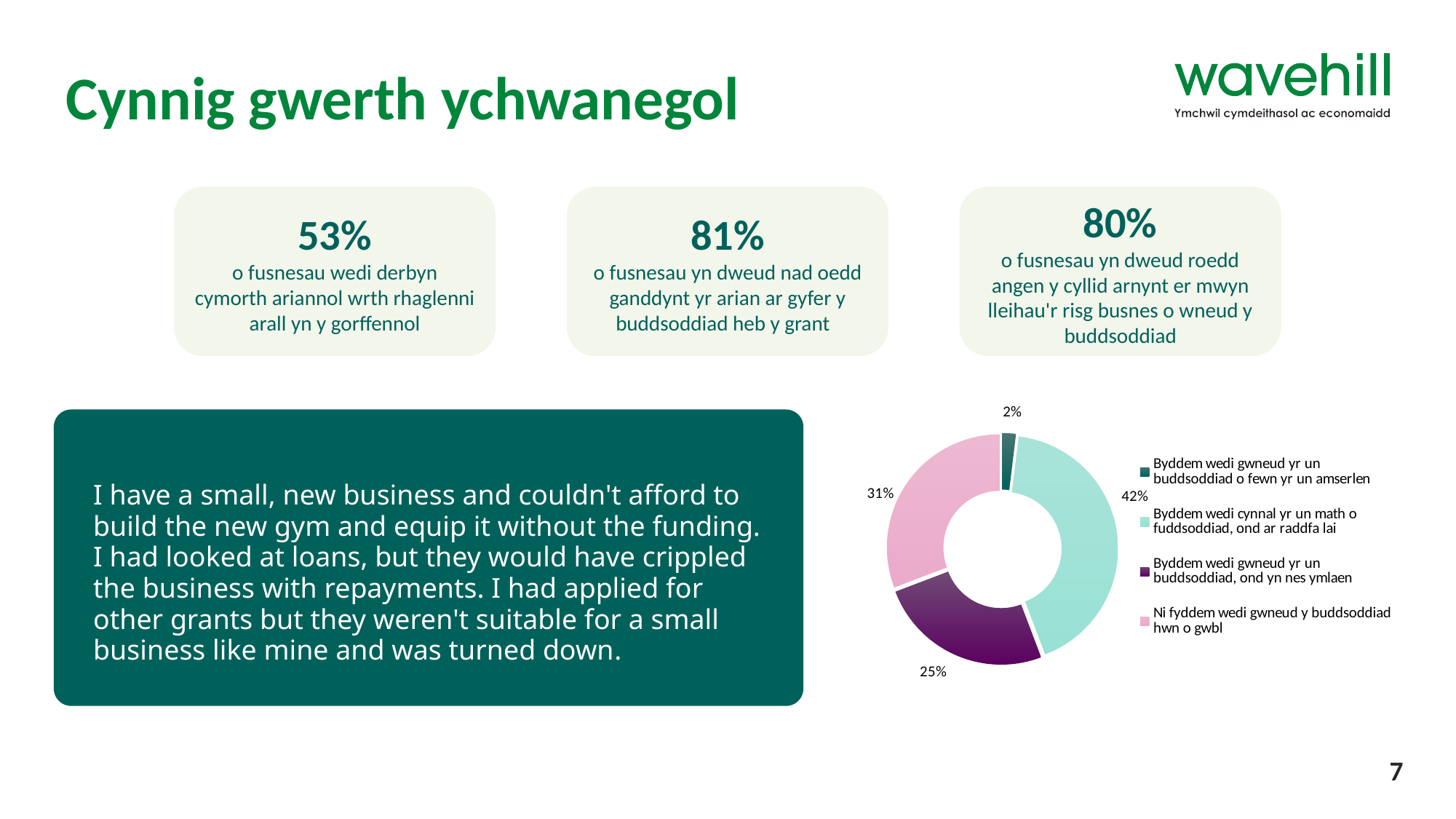
Which category has the smallest share of the donut chart? Byddem wedi gwneud yr un buddsoddiad o fewn yr un amserlen What percentage of the donut chart is for 'Ni fyddem wedi gwneud y buddsoddiad hwn o gwbl'? 31% Which is larger in the donut chart: 'Ni fyddem wedi gwneud y buddsoddiad hwn o gwbl' or 'Byddem wedi gwneud yr un buddsoddiad, ond yn nes ymlaen'? Ni fyddem wedi gwneud y buddsoddiad hwn o gwbl What percentage of the donut chart is for 'Byddem wedi cynnal yr un math o fuddsoddiad, ond ar raddfa lai'? 42% How many categories does the donut chart show? 4 What kind of chart is shown on the slide? Donut (pie) chart What percentage of the donut chart is for 'Byddem wedi gwneud yr un buddsoddiad o fewn yr un amserlen'? 2% What percentage of the donut chart is for 'Byddem wedi gwneud yr un buddsoddiad, ond yn nes ymlaen'? 25% Which category has the largest share of the donut chart? Byddem wedi cynnal yr un math o fuddsoddiad, ond ar raddfa lai What is the difference in percentage points between the 42% slice and the 31% slice of the donut chart? 11 percentage points What is the combined share of the 25% and 31% slices in the donut chart? 56% What colour is the slice for 'Ni fyddem wedi gwneud y buddsoddiad hwn o gwbl' in the donut chart? Pink